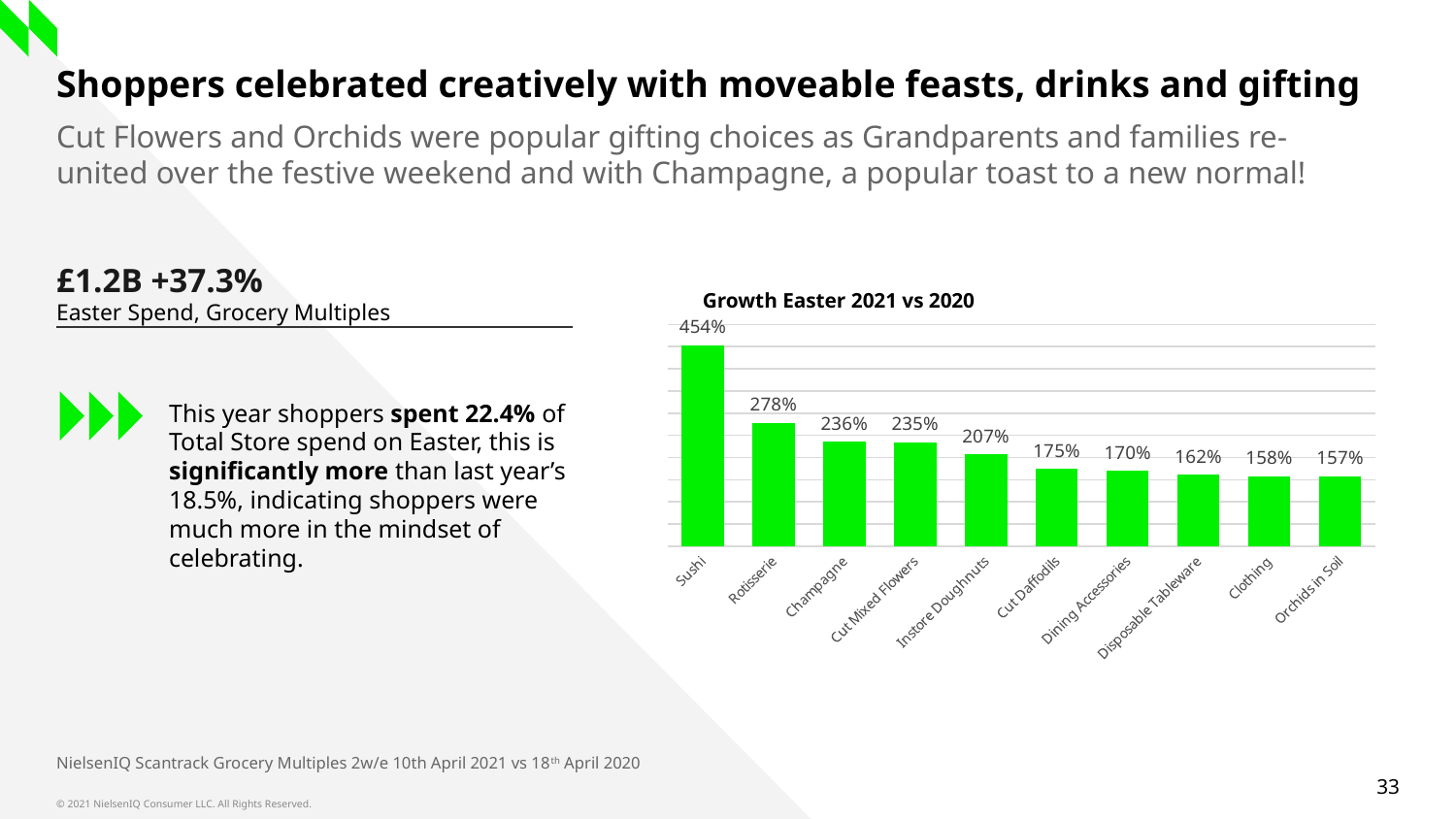
What is the growth value for Cut Daffodils? 175% What is the growth value for Sushi? 454% How many categories are shown in the chart? 10 Which category has the lowest growth? Orchids in Soil What is the difference between the growth for Instore Doughnuts and Clothing? 49% What is the growth value for Orchids in Soil? 157% What is the difference between the growth for Sushi and Rotisserie? 176% Which category has the highest growth? Sushi What is the title of the chart? Growth Easter 2021 vs 2020 What kind of chart is shown on the slide? Bar chart Which has higher growth, Rotisserie or Dining Accessories? Rotisserie What is the growth value for Champagne? 236%